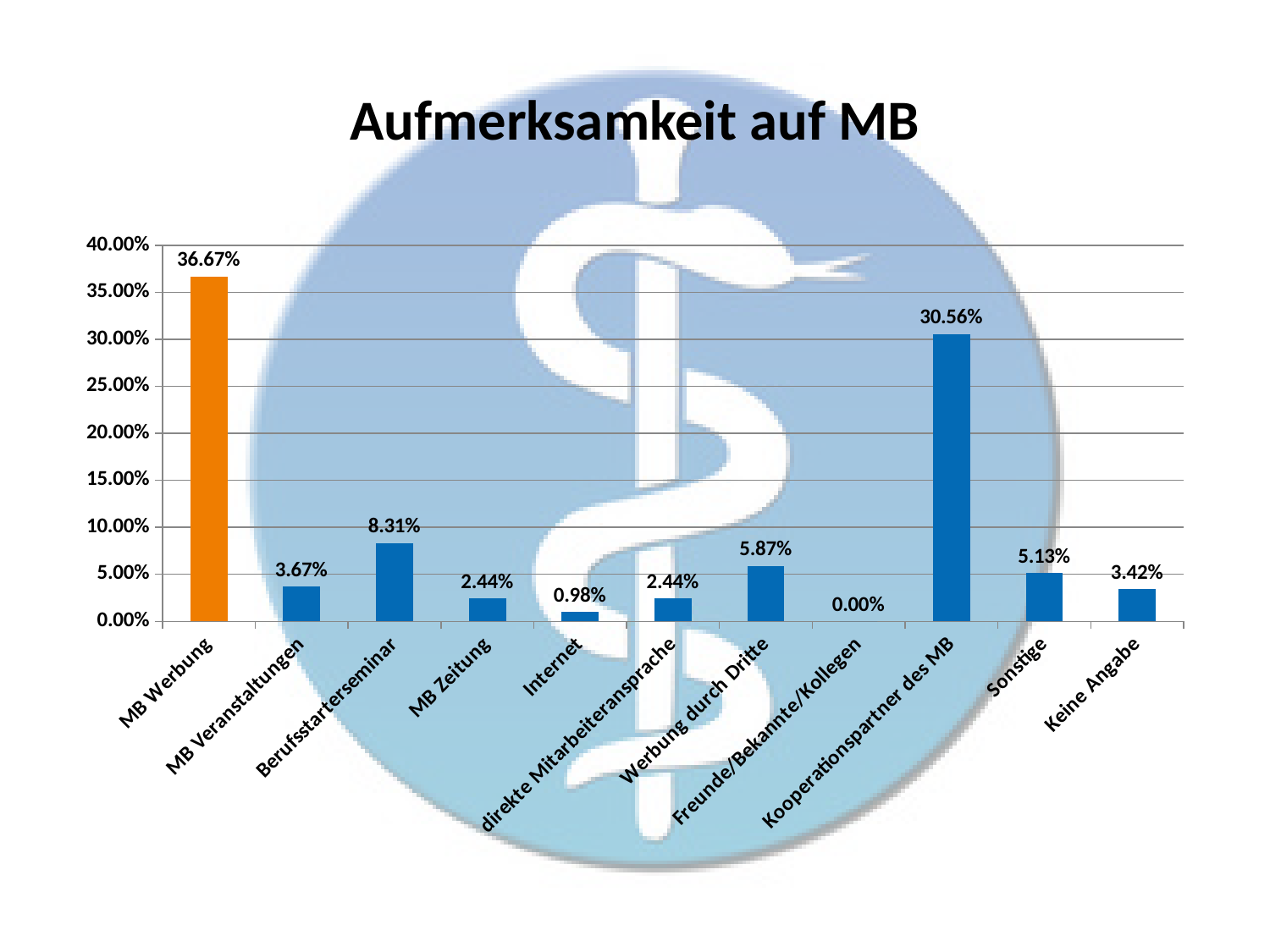
What is the value for MB Werbung? 36.67% What is the difference between the values for MB Werbung and Kooperationspartner des MB? 6.11% What is the value for Kooperationspartner des MB? 30.56% Which category has the lowest value? Freunde/Bekannte/Kollegen What is the value for Berufsstarterseminar? 8.31% Which category has the highest value? MB Werbung How many categories are shown on the x axis? 11 What kind of chart is shown on the slide? bar chart What is the title of the chart? Aufmerksamkeit auf MB What is the value for Internet? 0.98% Is the value for Werbung durch Dritte greater or less than 5.00%? greater Which is larger, the value for Sonstige or the value for Keine Angabe? Sonstige